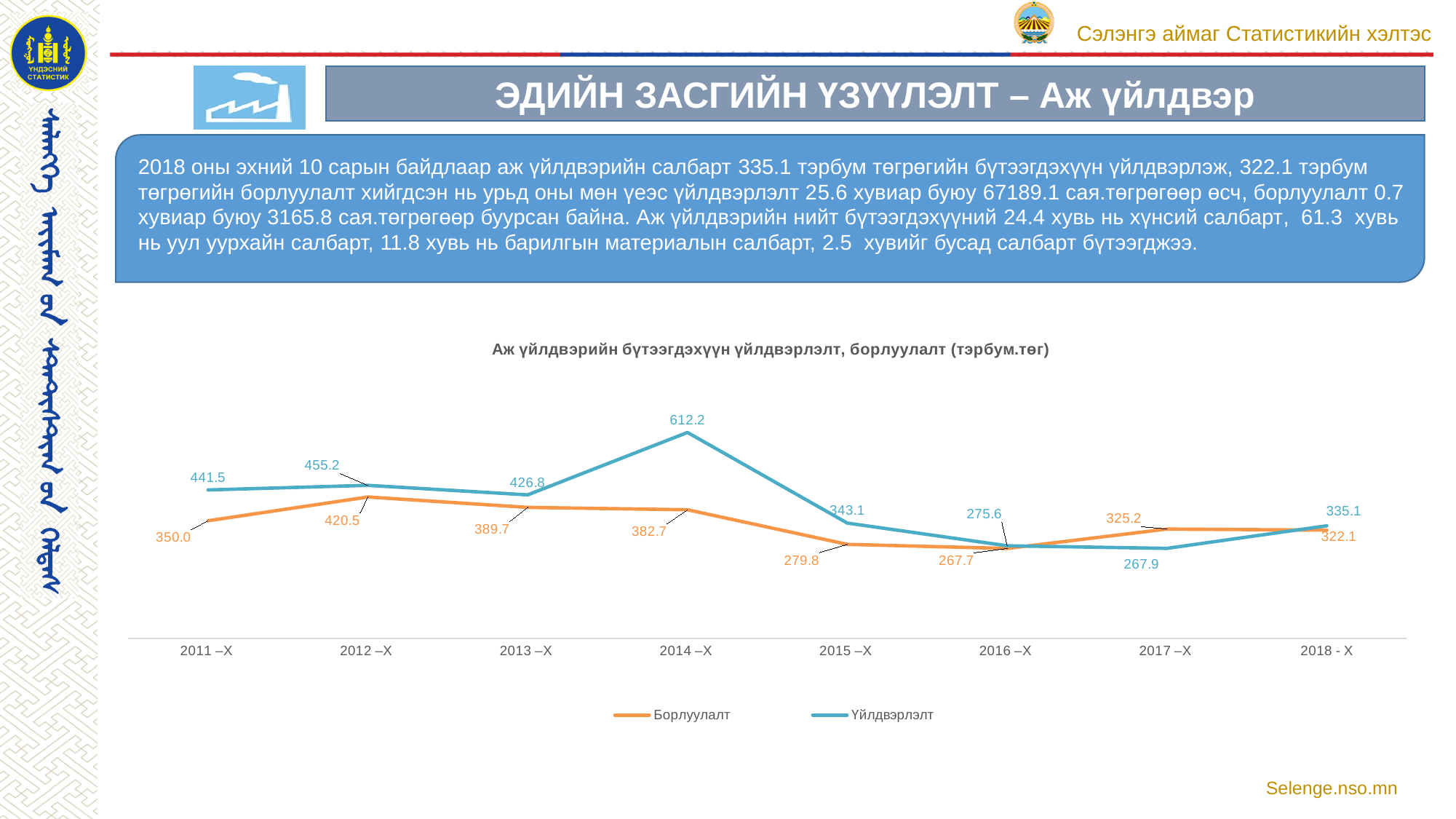
What is the title of the chart? Аж үйлдвэрийн бүтээгдэхүүн үйлдвэрлэлт, борлуулалт (тэрбум.төг) What is the value of Борлуулалт for 2018 - X? 322.1 Which is larger in 2017 –X, Борлуулалт or Үйлдвэрлэлт? Борлуулалт What type of chart is shown on the slide? line chart In which year does Үйлдвэрлэлт reach its highest value? 2014 –X Does Үйлдвэрлэлт rise or fall from 2014 –X to 2016 –X? fall In which year is Борлуулалт at its lowest value? 2016 –X How many series does the legend list? 2 What is the value of Борлуулалт for 2011 –X? 350.0 What is the difference between Үйлдвэрлэлт and Борлуулалт in 2018 - X? 13.0 How many time points are plotted along the x axis? 8 What is the value of Үйлдвэрлэлт for 2014 –X? 612.2